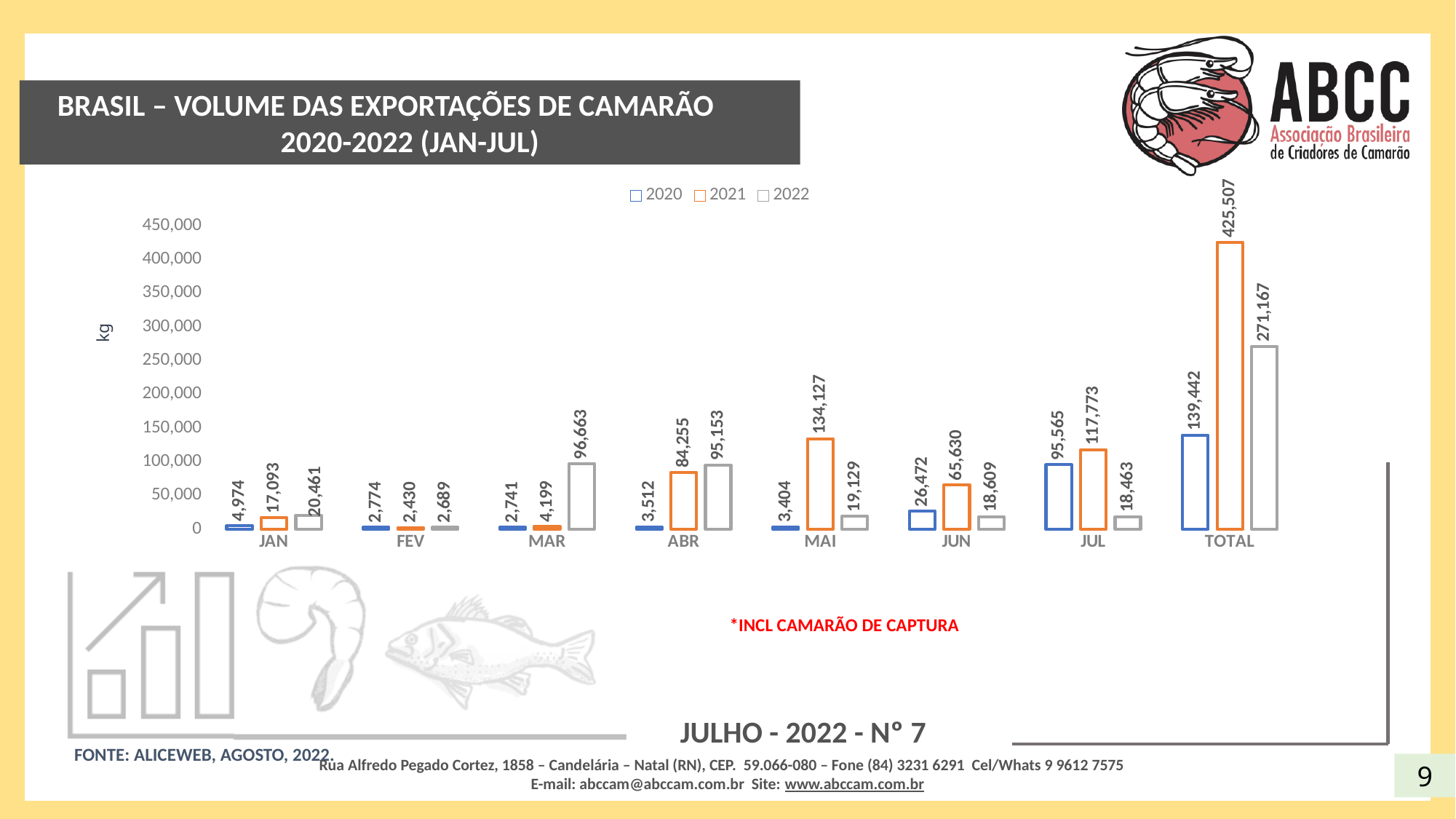
How many categories are shown on the x axis? 8 What is the difference between the 2021 and 2020 values for TOTAL? 286,065 Which month has the lowest 2022 value? FEV Is the 2022 value for TOTAL greater or less than 250,000? greater What is the 2021 value for MAI? 134,127 What kind of chart is shown on the slide? bar chart What is the 2022 value for MAR? 96,663 Which is larger for ABR, the 2021 value or the 2022 value? 2022 What is the 2021 value for TOTAL? 425,507 What is the 2020 value for JUL? 95,565 How many series does the legend list? 3 Which month has the highest 2021 value (excluding TOTAL)? MAI